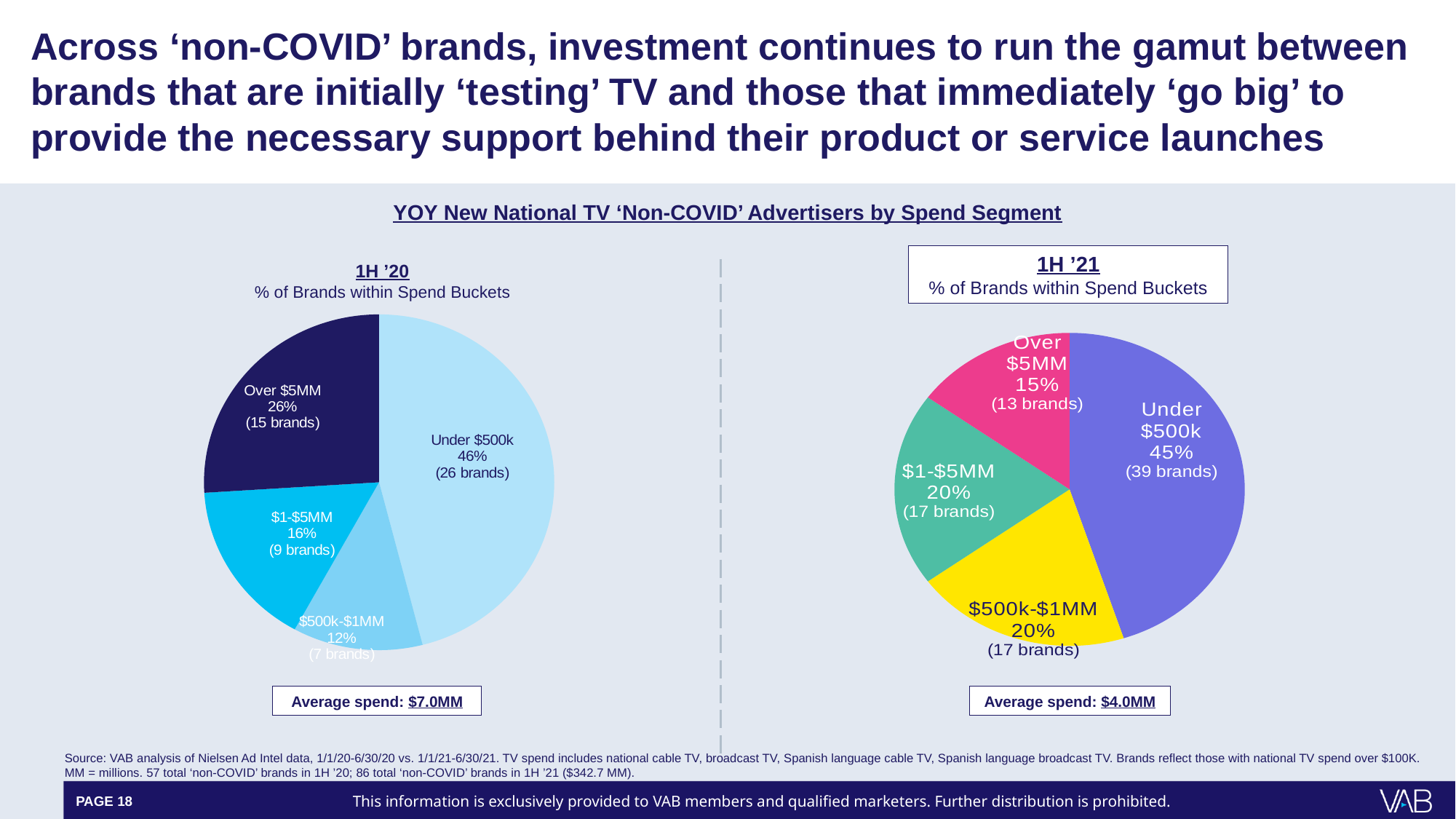
In the 1H '21 pie chart, which spend bucket has the largest share of brands? Under $500k What is the title above the two pie charts? YOY New National TV 'Non-COVID' Advertisers by Spend Segment In the 1H '20 pie chart, what share of the pie does the $1-$5MM bucket represent? 16% In the 1H '21 pie chart, how many more brands are in the Under $500k bucket than in the Over $5MM bucket? 26 brands What is the average spend shown below the 1H '21 pie chart? $4.0MM In the 1H '20 pie chart, what percentage of brands are in the Under $500k spend bucket? 46% In the 1H '21 pie chart, how many brands are in the Over $5MM spend bucket? 13 brands How many spend buckets are shown in the 1H '21 pie chart? 4 What type of chart is used to show the 1H '20 brands by spend bucket? Pie chart Which has a larger share of brands in the Over $5MM bucket: 1H '20 or 1H '21? 1H '20 In the 1H '20 pie chart, which spend bucket has the smallest share of brands? $500k-$1MM In the 1H '20 pie chart, what is the difference in percentage points between the Over $5MM and $1-$5MM buckets? 10 percentage points